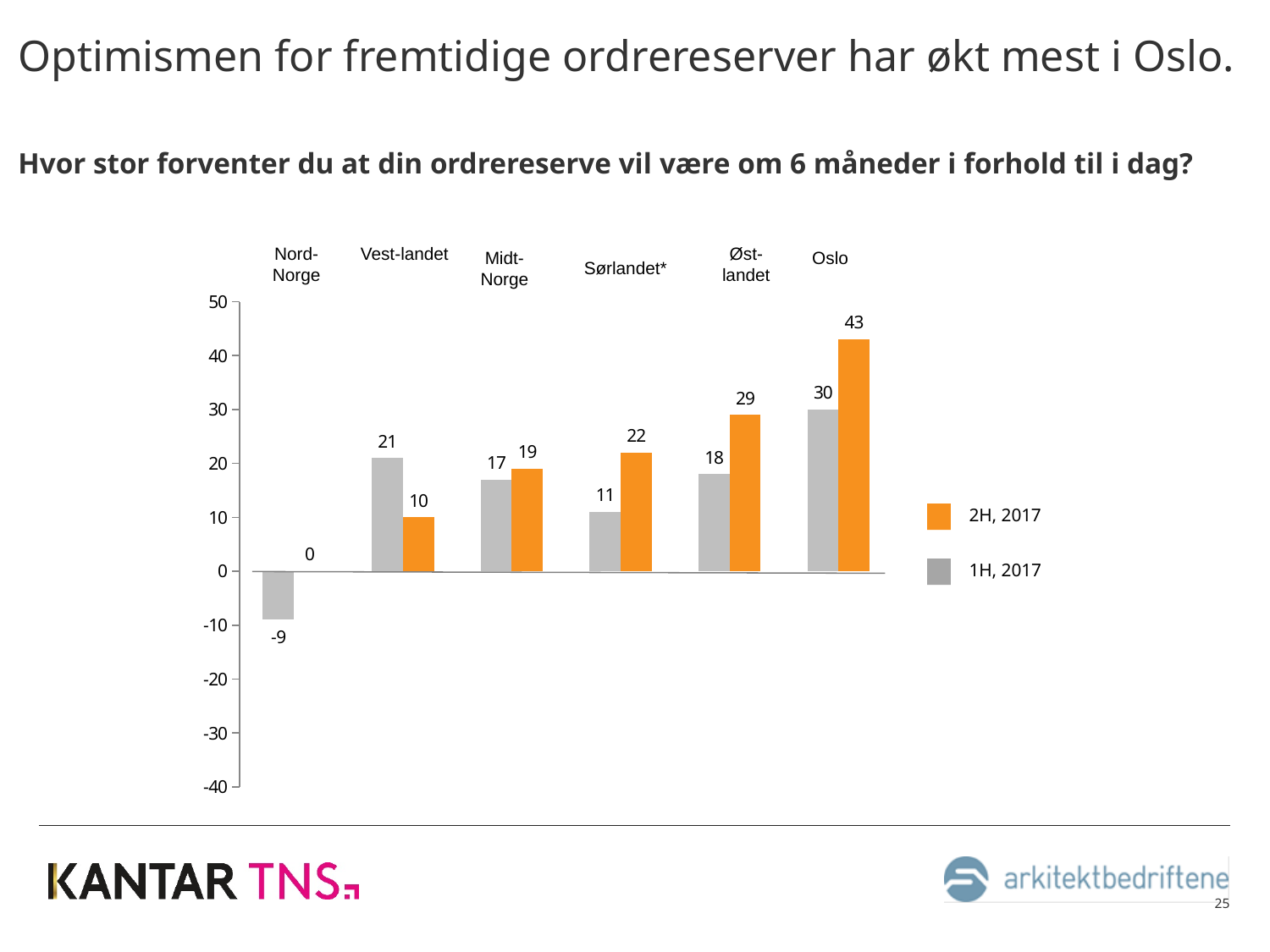
Which region has the lowest value in the 1H, 2017 series? Nord-Norge What is the value for Vest-landet in the 1H, 2017 series? 21 What is the value for Oslo in the 2H, 2017 series? 43 How many series does the legend list? 2 Which is larger for Øst-landet: the 1H, 2017 value or the 2H, 2017 value? 2H, 2017 How many regions are shown on the x axis? 6 What is the difference between the 2H, 2017 and 1H, 2017 values for Oslo? 13 Which region has the highest value in the 2H, 2017 series? Oslo What is the difference between the 1H, 2017 and 2H, 2017 values for Vest-landet? 11 What kind of chart is shown on the slide? Bar chart What is the value for Nord-Norge in the 1H, 2017 series? -9 What is the value for Sørlandet* in the 2H, 2017 series? 22